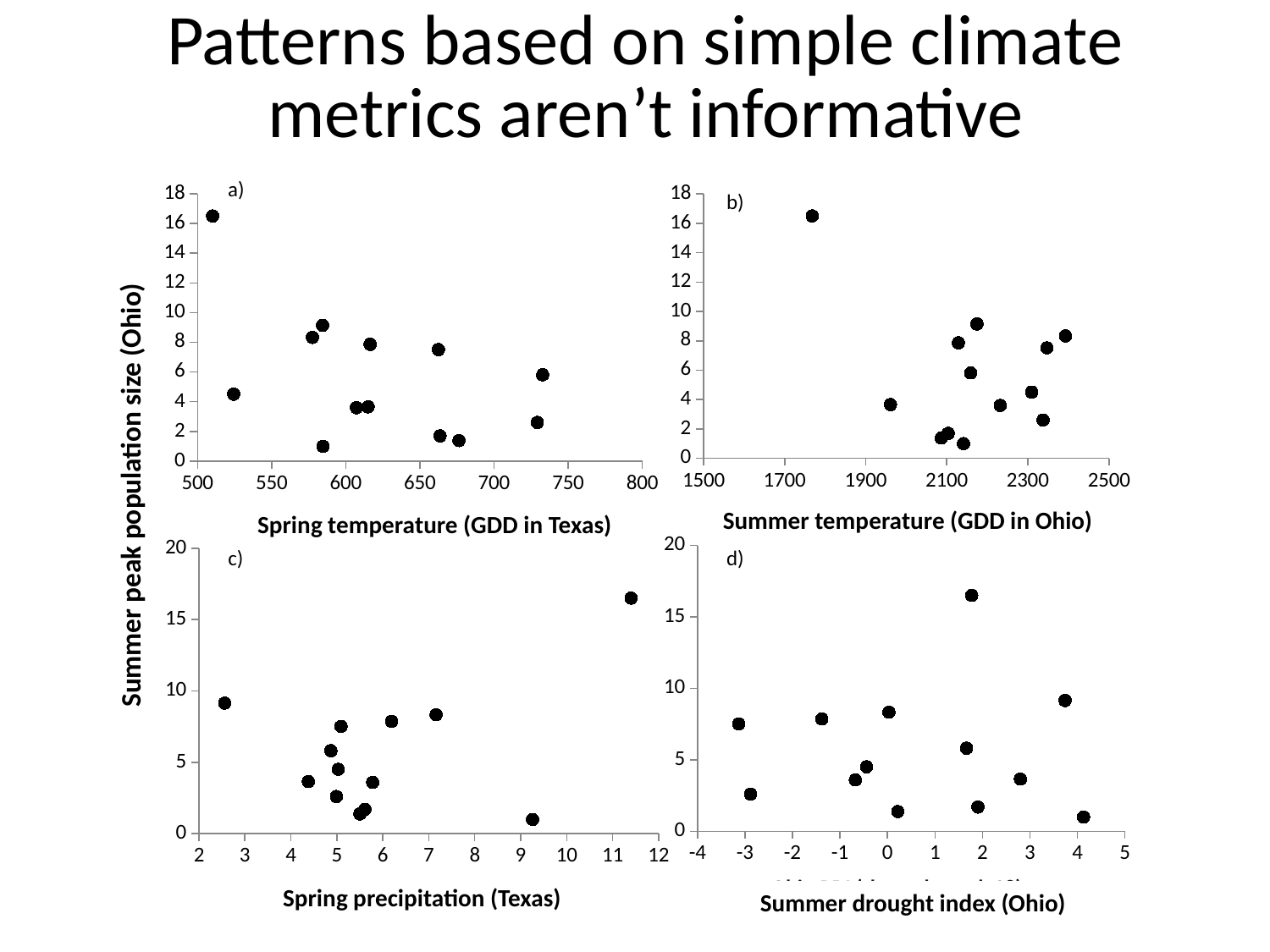
In chart c) (Spring precipitation), is the value of the point near 2.5 on the x axis greater or less than 5? greater In chart c) (Spring precipitation, Texas), is the value of the point near 9.3 on the x axis greater or less than 5? less In chart a) (Spring temperature), is the value of the highest point greater or less than 14? greater What kind of chart is chart a) (top left)? Scatter plot What is the x-axis label of chart c) (bottom left)? Spring precipitation (Texas) How many data points are plotted in chart a) (Spring temperature, GDD in Texas)? 13 How many data points are plotted in chart d) (Summer drought index, Ohio)? 13 What is the shared y-axis label of the four charts? Summer peak population size (Ohio) In chart a) (Spring temperature), which is larger: the value of the point near 510 on the x axis or the value of the point near 525 on the x axis? The point near 510